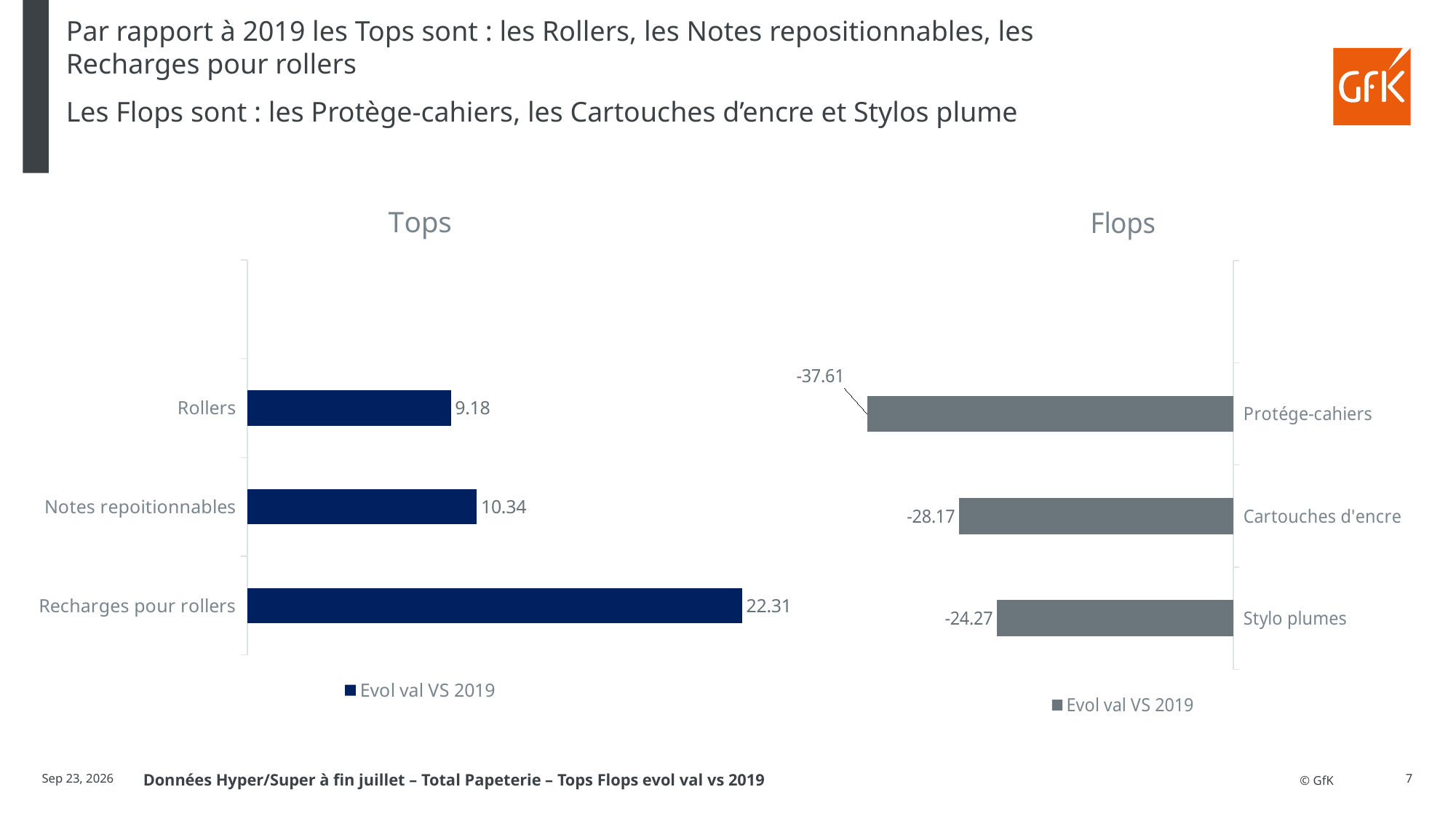
In the Flops chart, what is the value for Protége-cahiers? -37.61 In the Tops chart, what is the value for Recharges pour rollers? 22.31 How many categories are shown in the Flops chart? 3 What type of chart is the Tops chart? Bar chart In the Flops chart, what is the difference between the values for Cartouches d'encre and Stylo plumes? 3.90 In the Tops chart, which is larger, the value for Rollers or the value for Notes repoitionnables? Notes repoitionnables In the Flops chart, what is the value for Stylo plumes? -24.27 What is the legend entry shown under the Flops chart? Evol val VS 2019 In the Tops chart, which category has the highest value? Recharges pour rollers In the Tops chart, what is the value for Rollers? 9.18 In the Tops chart, what is the difference between the values for Recharges pour rollers and Notes repoitionnables? 11.97 In the Flops chart, which category has the lowest value? Protége-cahiers